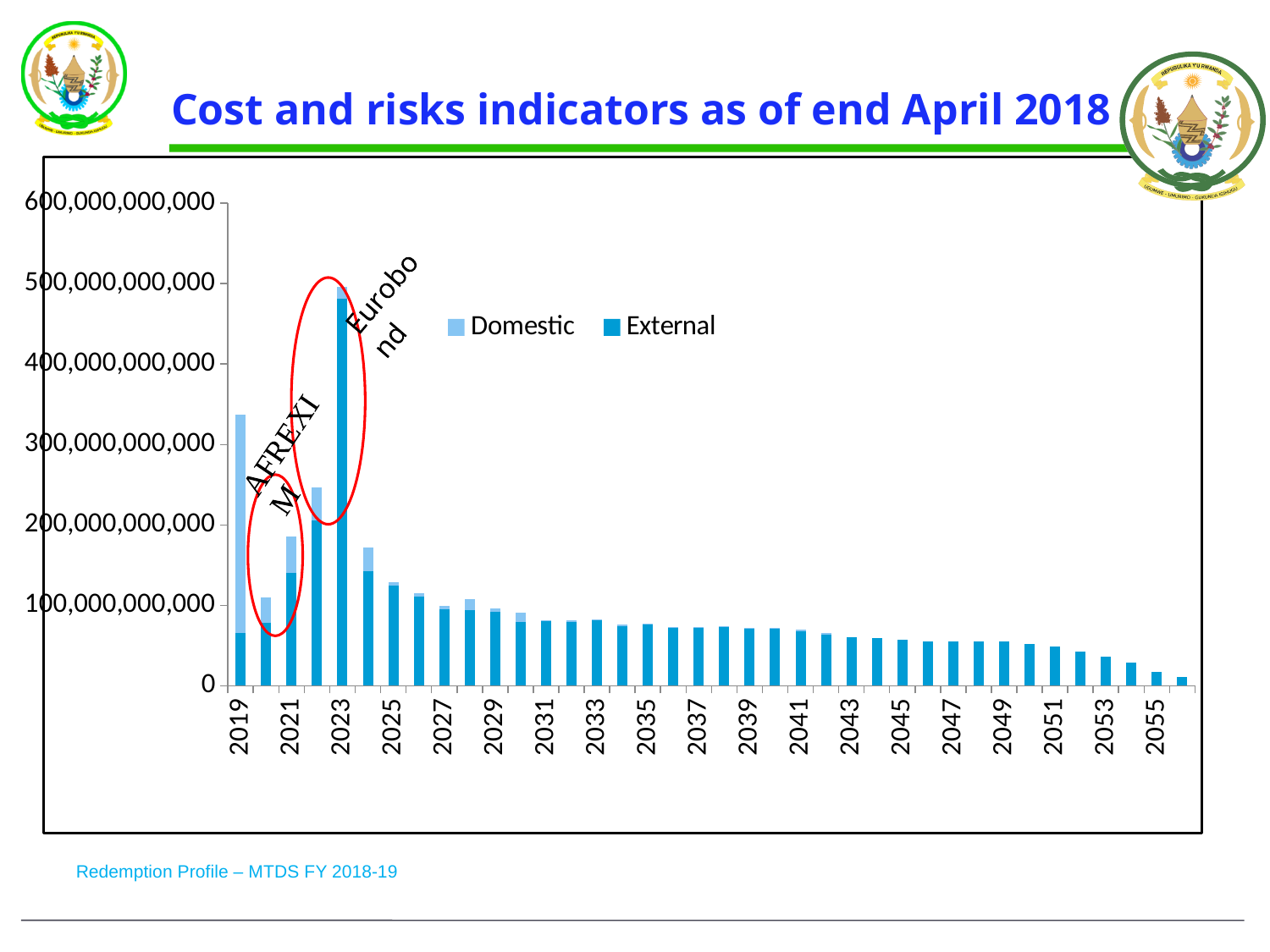
Which year has the tallest bar in the chart? 2023 Is the total value for 2031 greater or less than 100,000,000,000? less Which two series are listed in the chart legend? Domestic and External Is the total value for 2055 greater or less than 100,000,000,000? less How many series does the chart legend list? 2 Which year has the larger total bar, 2019 or 2021? 2019 Which two items are circled and annotated on the chart? AFREXIM and Eurobond Is the total value for 2019 greater or less than 300,000,000,000? greater Do the bar values generally rise or fall from 2025 to 2055? fall What kind of chart is shown on the slide? Stacked bar chart